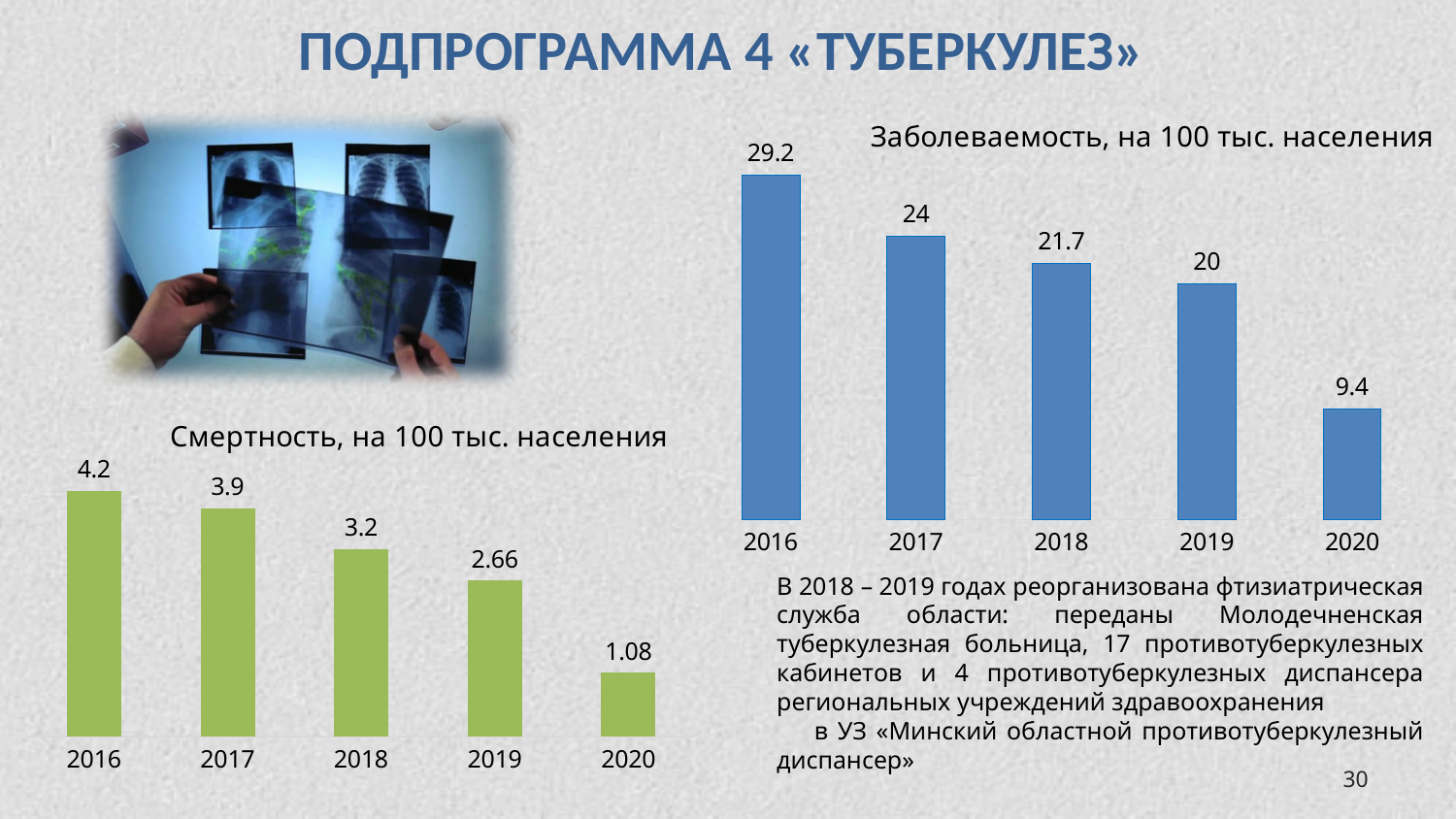
How many years are shown in the chart titled "Смертность, на 100 тыс. населения"? 5 In the chart titled "Смертность, на 100 тыс. населения", what is the difference between the values for 2016 and 2020? 3.12 In the chart titled "Заболеваемость, на 100 тыс. населения", what is the difference between the values for 2017 and 2018? 2.3 In the chart titled "Заболеваемость, на 100 тыс. населения", which is larger, the value for 2019 or the value for 2020? 2019 In the chart titled "Заболеваемость, на 100 тыс. населения", what is the value for 2016? 29.2 In the chart titled "Заболеваемость, на 100 тыс. населения", which year has the lowest value? 2020 In the chart titled "Заболеваемость, на 100 тыс. населения", what is the value for 2018? 21.7 What colour are the bars in the chart titled "Смертность, на 100 тыс. населения"? green In the chart titled "Смертность, на 100 тыс. населения", which year has the highest value? 2016 In the chart titled "Смертность, на 100 тыс. населения", what is the value for 2019? 2.66 In the chart titled "Смертность, на 100 тыс. населения", do the values rise or fall from 2016 to 2020? fall What kind of chart is the chart titled "Заболеваемость, на 100 тыс. населения"? bar chart